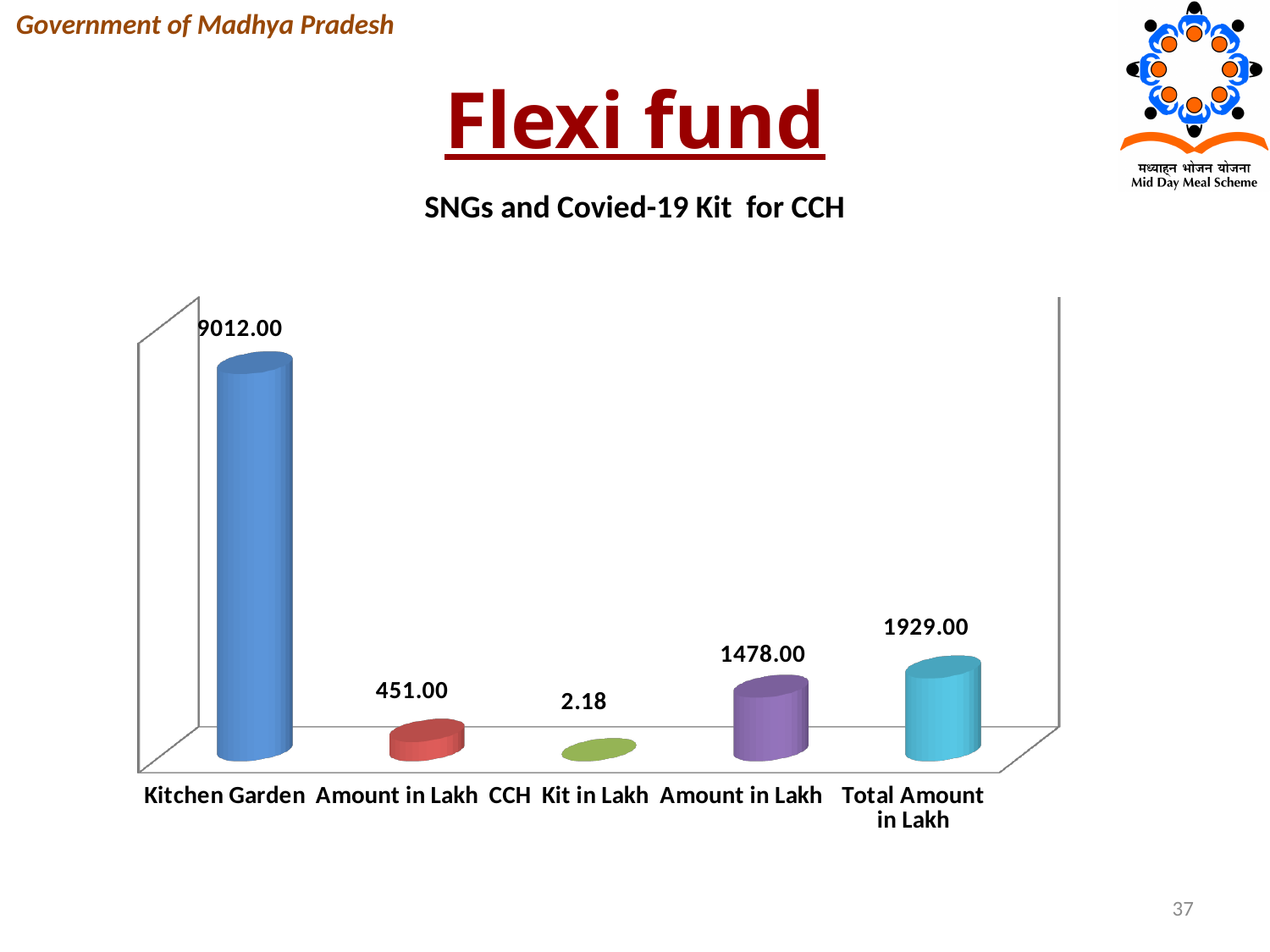
What is the subtitle shown above the chart? SNGs and Covied-19 Kit for CCH What is the value shown on the purple bar, the second from the right? 1478.00 What is the main title of the slide? Flexi fund What kind of chart is shown on the slide? bar chart What is the difference between the Total Amount in Lakh bar (1929.00) and the purple bar (1478.00)? 451.00 What is the lowest value shown on the chart? 2.18 Which is larger, the value of the red bar or the value of the purple bar? the purple bar (1478.00) What is the value shown on the blue bar labelled Kitchen Garden? 9012.00 What is the value shown on the green bar in the middle of the chart? 2.18 What is the value shown on the red bar, the second from the left? 451.00 Which bar has the highest value? Kitchen Garden (9012.00) What is the value shown on the rightmost bar, labelled Total Amount in Lakh? 1929.00